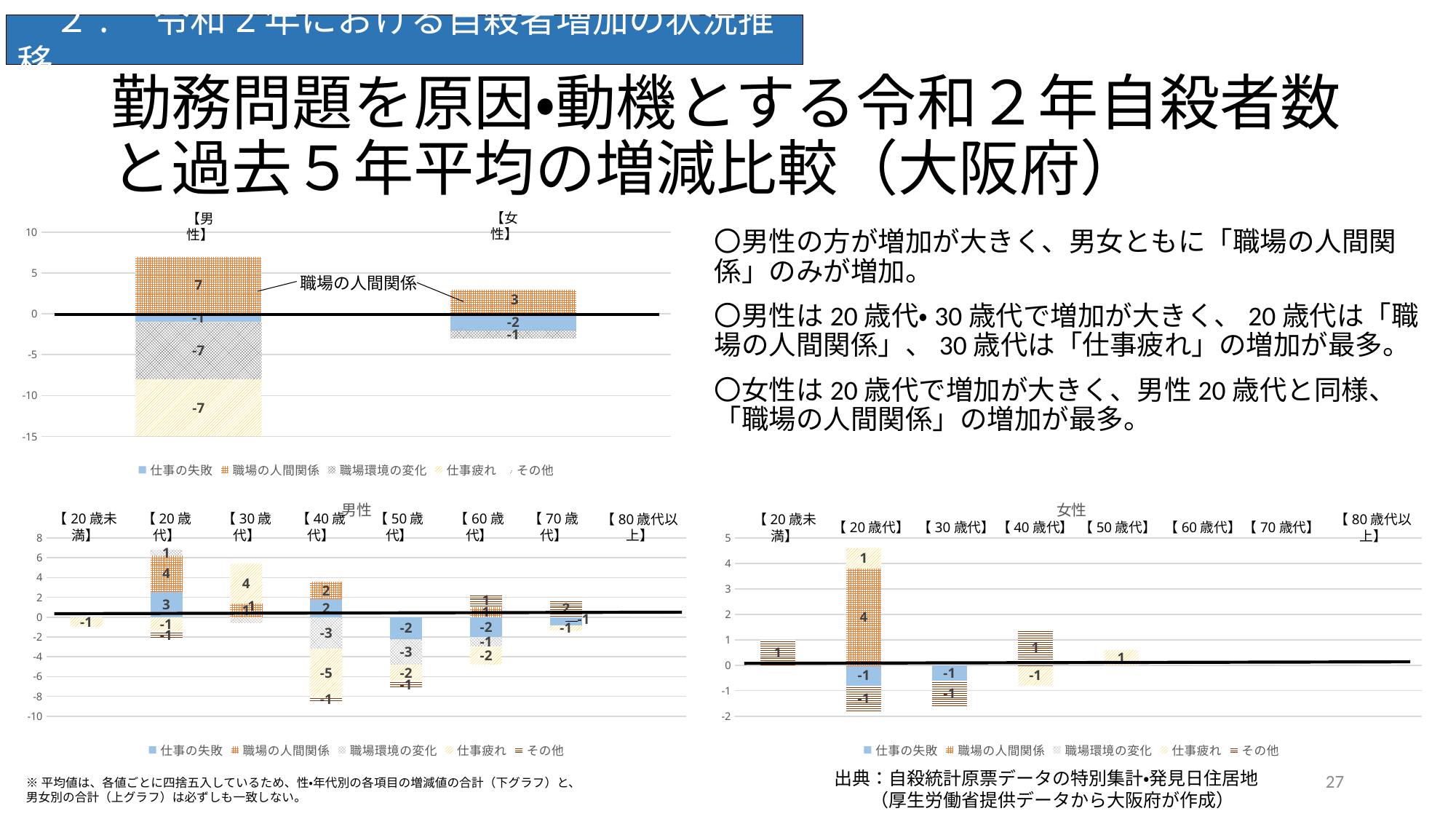
In the top-left chart, what is the value for 仕事の失敗 for 女性? -2 In the top-left chart, what is the value for 職場の人間関係 for 男性? 7 In the 男性 chart (bottom left), what is the value for 仕事疲れ in the 30歳代 category? 4 In the 女性 chart (bottom right), what is the value for 職場の人間関係 in the 20歳代 category? 4 How many series does the legend of the 男性 chart (bottom left) list? 5 How many age categories are shown on the x axis of the 女性 chart (bottom right)? 8 In the top-left chart, what is the difference between the 職場の人間関係 value for 男性 and for 女性? 4 In the 男性 chart (bottom left), what is the value for 仕事疲れ in the 40歳代 category? -5 In the top-left chart, which is larger, the 職場の人間関係 value for 男性 or for 女性? 男性 In the 男性 chart (bottom left), what is the value for 仕事の失敗 in the 20歳代 category? 3 What kind of chart is the 女性 chart at the bottom right? Stacked bar chart In the top-left chart, what is the value for 職場の人間関係 for 女性? 3